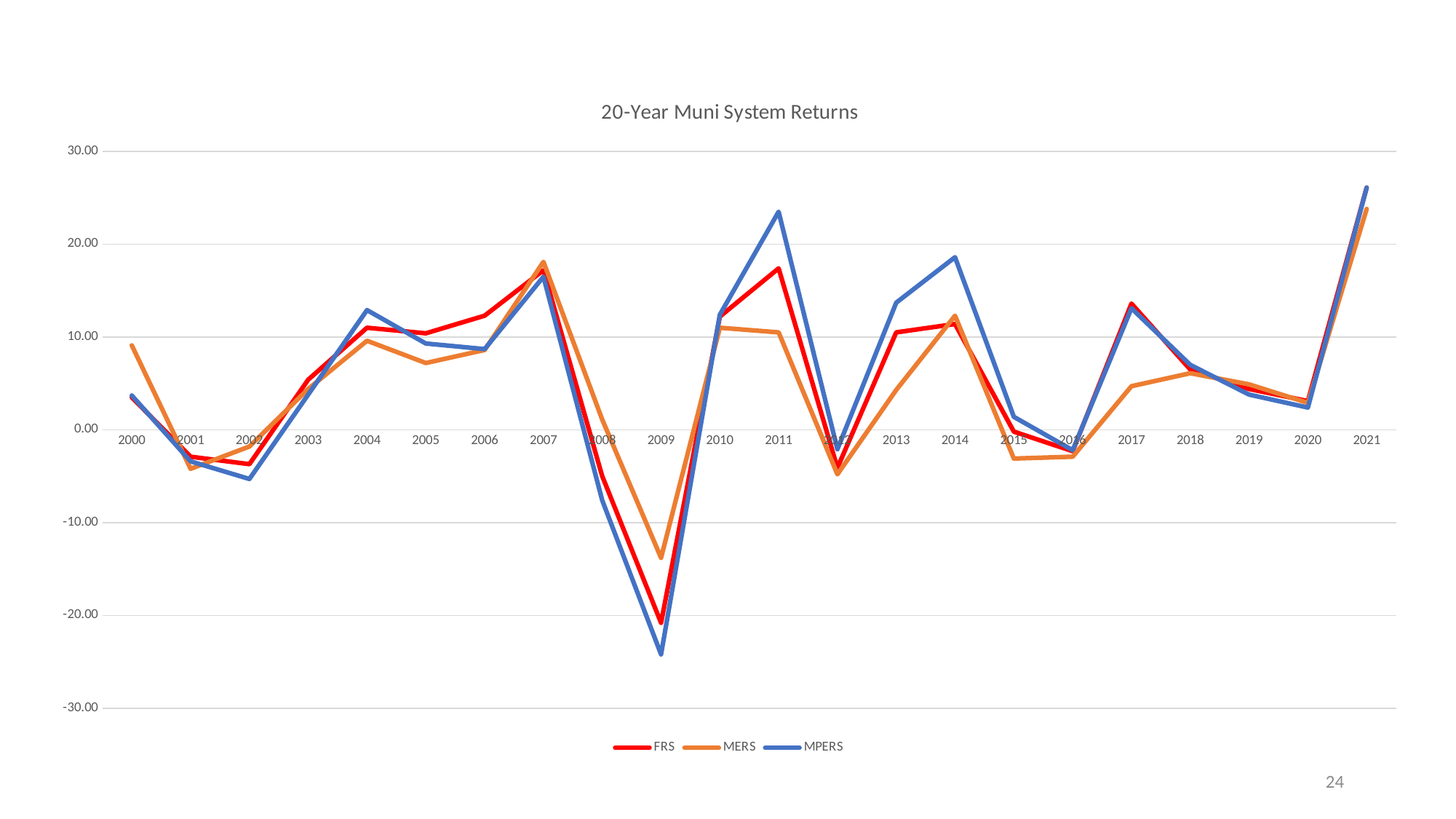
How many years are plotted along the x axis? 22 What kind of chart is shown on the slide? line chart What is the title of the chart? 20-Year Muni System Returns Is the value for MPERS in 2009 greater or less than -20.00? less Does the FRS series rise or fall from 2007 to 2009? fall In which year does the MPERS series reach its lowest value? 2009 Which colour is used for the FRS series? red In 2011, which series has the larger value, MPERS or MERS? MPERS In which year does the MPERS series reach its highest value? 2021 In which year does the MERS series reach its highest value? 2021 How many series does the legend list? 3 Is the value for MERS in 2009 greater or less than -20.00? greater